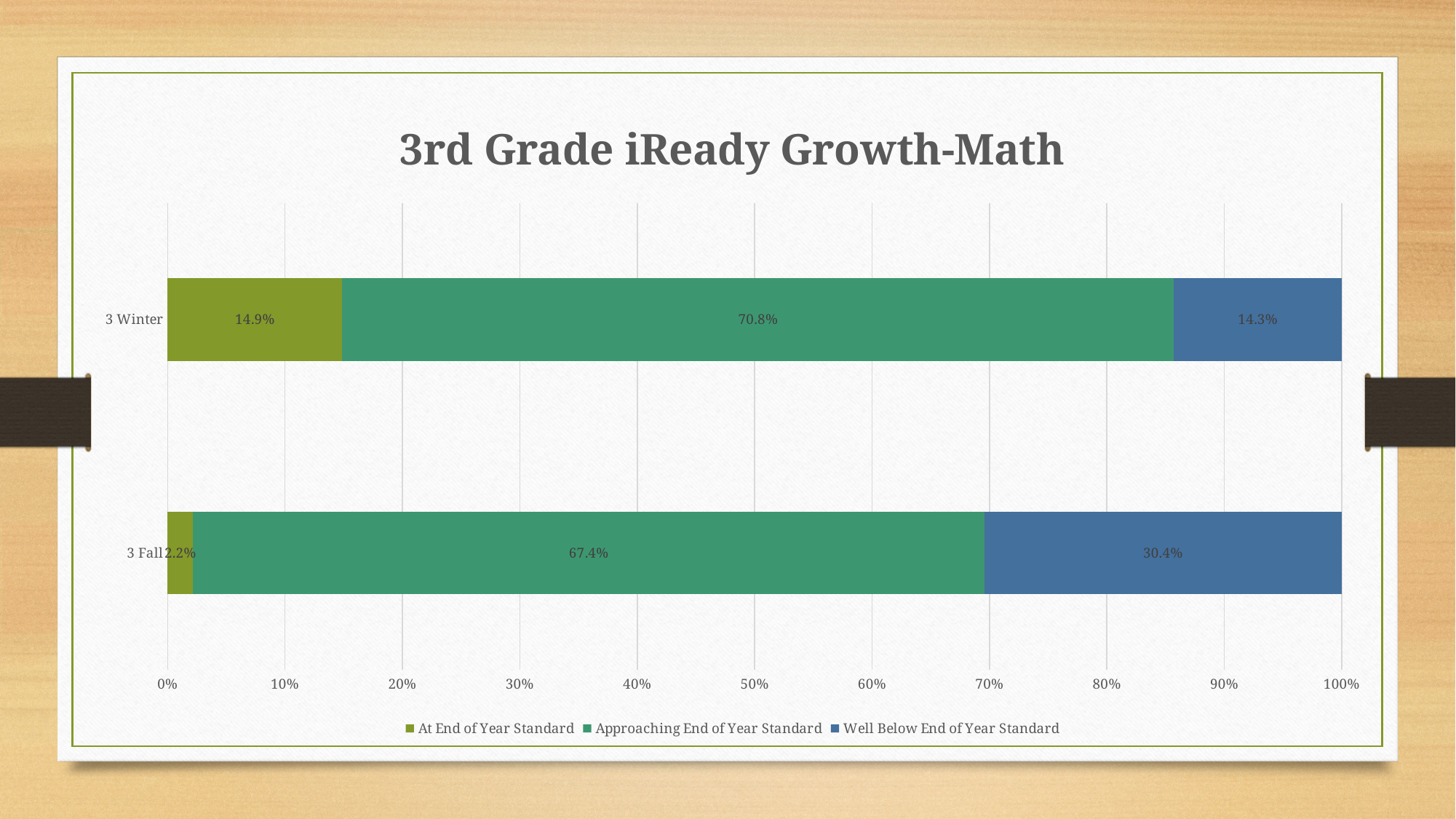
What is the value for Well Below End of Year Standard in 3 Winter? 14.3% How many series does the legend list? 3 Which category has the higher value for At End of Year Standard, 3 Winter or 3 Fall? 3 Winter What is the value for At End of Year Standard in 3 Winter? 14.9% Which series has the largest value in 3 Winter? Approaching End of Year Standard What is the difference between the At End of Year Standard values for 3 Winter and 3 Fall? 12.7% What is the title of the chart? 3rd Grade iReady Growth-Math How many categories are shown on the chart? 2 What kind of chart is shown on the slide? Stacked bar chart What is the difference between the Well Below End of Year Standard values for 3 Fall and 3 Winter? 16.1% What is the value for Approaching End of Year Standard in 3 Fall? 67.4% What is the value for Well Below End of Year Standard in 3 Fall? 30.4%